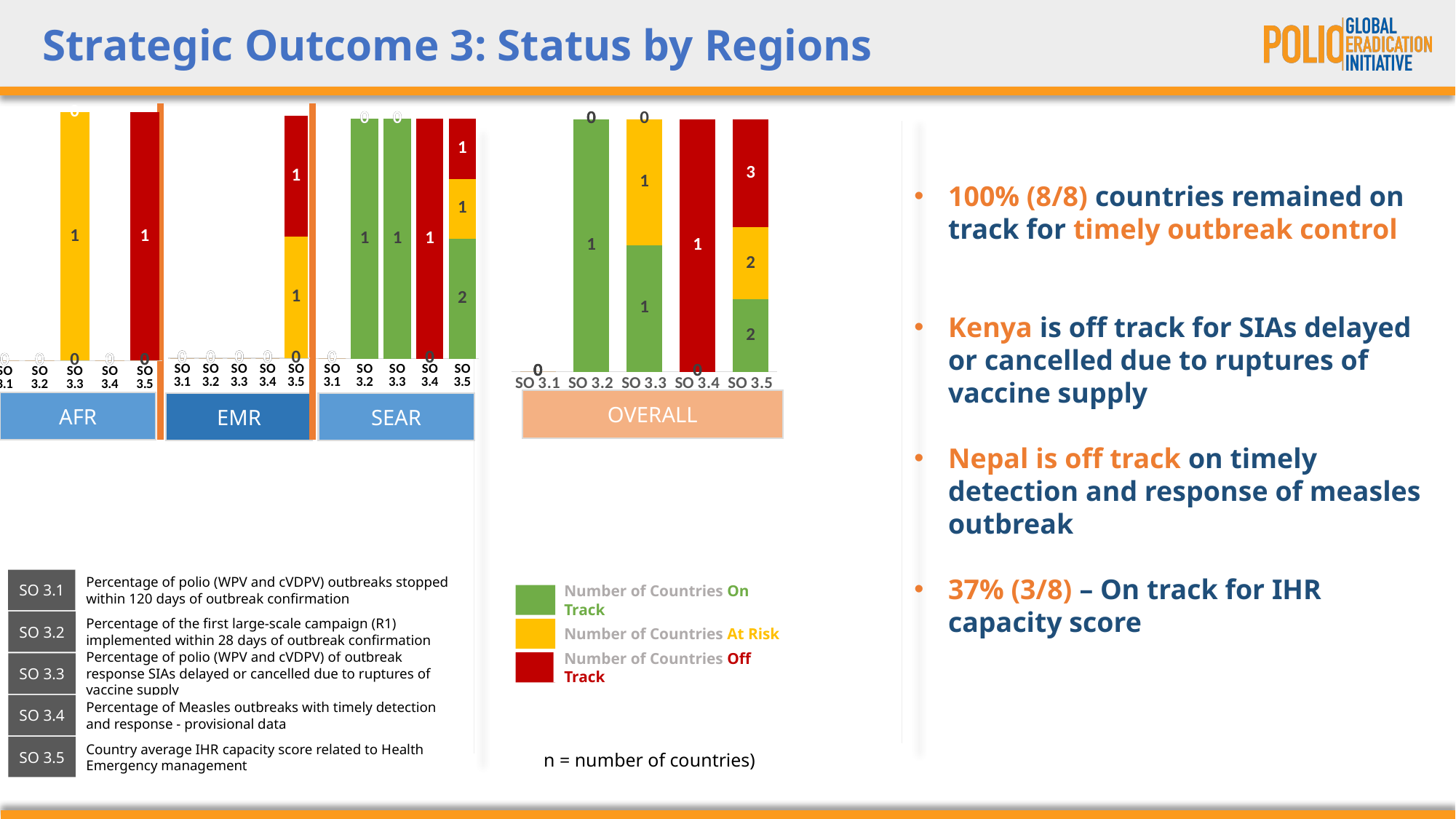
In the OVERALL chart, what is the difference between the number of countries Off Track and the number On Track for SO 3.5? 1 In the EMR chart, how many countries are At Risk for SO 3.5? 1 In the OVERALL chart, what is the total number of countries in the SO 3.5 stacked bar? 7 How many series does the legend list? 3 What kind of chart is the OVERALL chart? Stacked bar chart In the SEAR chart, what is the total number of countries in the SO 3.5 stacked bar? 4 In the OVERALL chart, how many countries are On Track for SO 3.5? 2 In the AFR chart, how many countries are Off Track for SO 3.5? 1 In the OVERALL chart, how many countries are Off Track for SO 3.5? 3 In the OVERALL chart, how many countries are At Risk for SO 3.3? 1 In the SEAR chart, how many countries are On Track for SO 3.5? 2